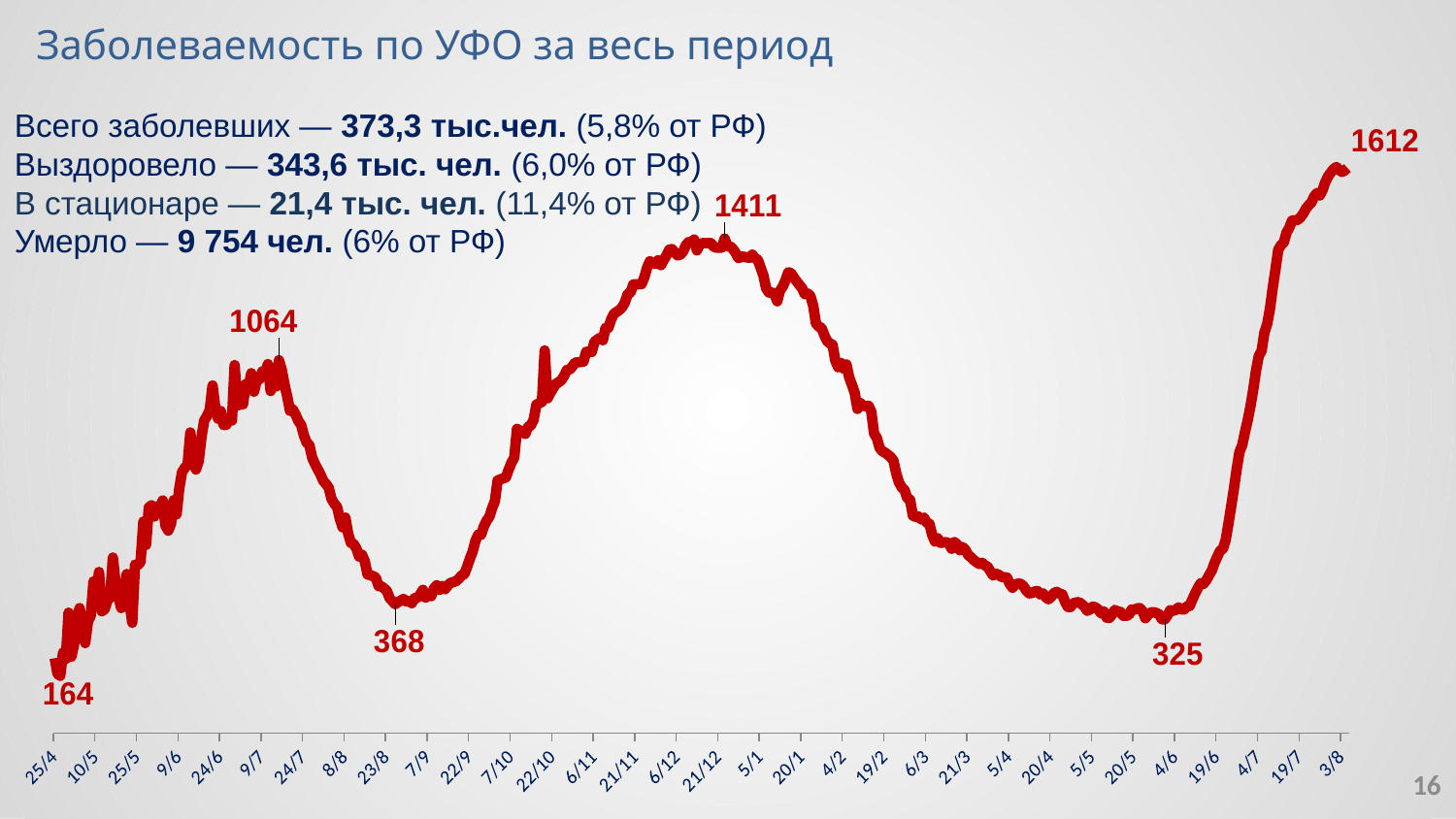
What is the difference between the labeled peak 1064 and the labeled low 368? 696 What is the highest labeled value on the chart? 1612 What is the value of the first labeled point at the start of the line? 164 What is the value of the labeled low point near 4/6? 325 What is the difference between the final labeled value (1612) and the peak labeled 1411? 201 How many data labels are printed on the line? 6 What is the lowest labeled value on the chart? 164 Does the line rise or fall between 4/6 and 3/8? Rises What is the value of the labeled peak near 21/12? 1411 What is the value of the last labeled point at the end of the line? 1612 What kind of chart is shown on the slide? Line chart Which labeled peak is larger: the one near 9/7 or the one near 21/12? The one near 21/12 (1411)